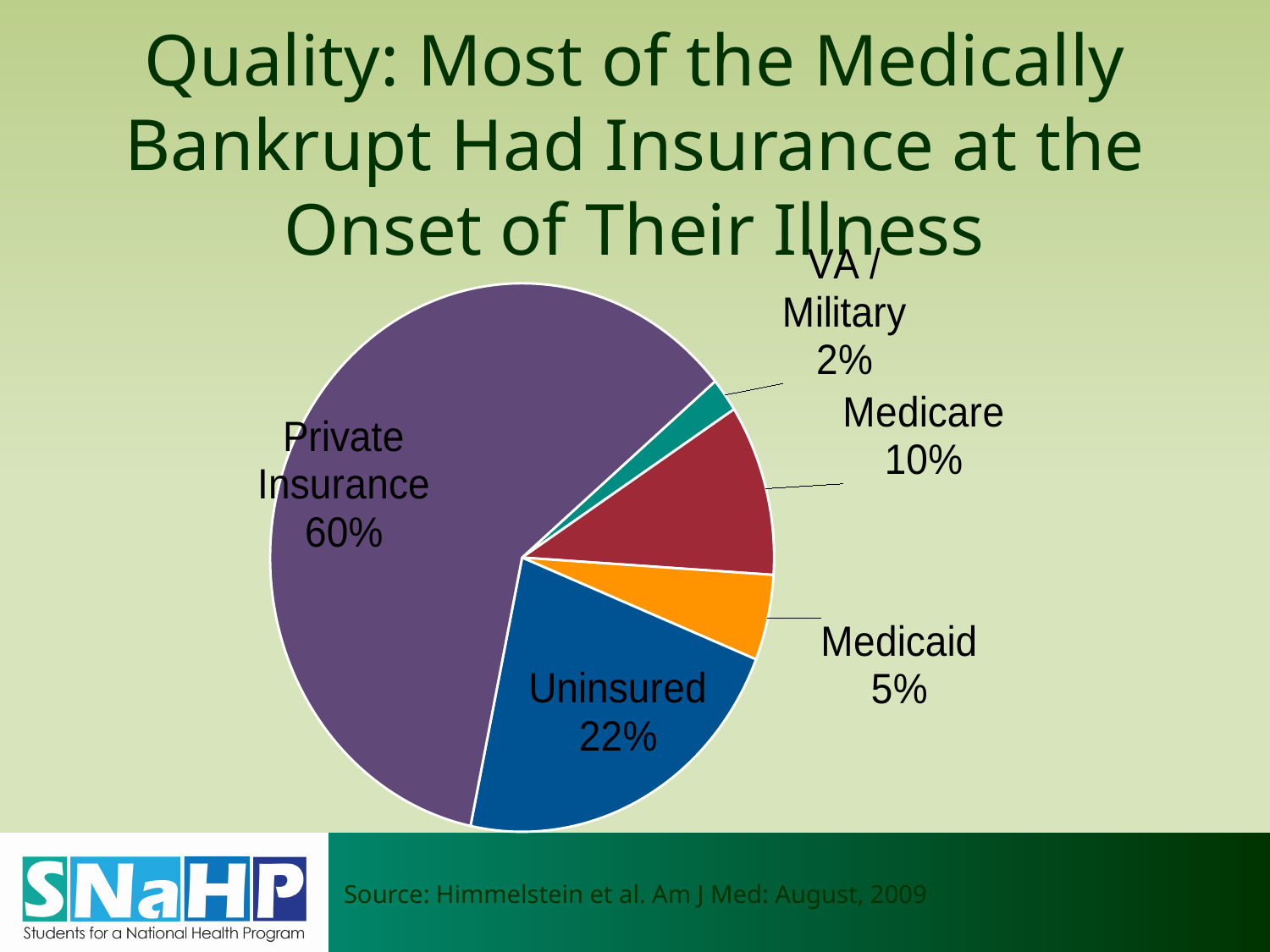
What is the value shown for Uninsured? 22% Which is larger, the Medicare slice or the Medicaid slice? Medicare Which category has the smallest slice of the pie? VA / Military Which category has the largest slice of the pie? Private Insurance What is the value shown for VA / Military? 2% What kind of chart is shown on the slide? pie chart How many categories are shown in the pie chart? 5 What is the value shown for Medicare? 10% What share of the pie does Private Insurance represent? 60% What is the difference between the Private Insurance share and the Uninsured share? 38% What is the value shown for Medicaid? 5% What colour is the Uninsured slice? blue